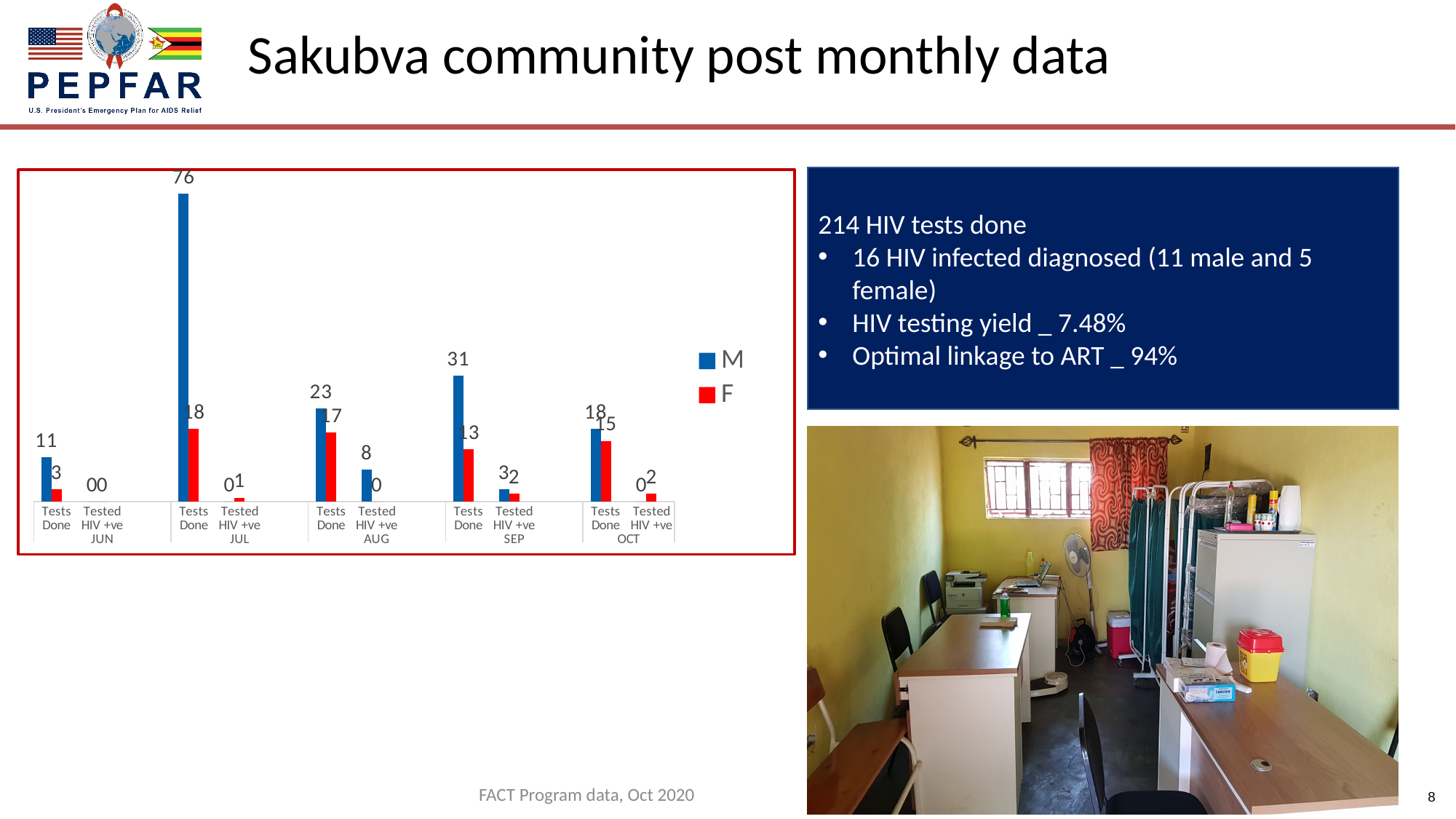
Which is larger for Tests Done in OCT, the M value or the F value? M Which colour represents the F series in the chart? red What is the total of the M and F values for Tests Done in JUN? 14 What is the value for F for Tested HIV +ve in OCT? 2 What type of chart is shown on the slide? bar chart What is the value for F for Tests Done in AUG? 17 In which month is the M value for Tests Done the highest? JUL In which month is the F value for Tests Done the lowest? JUN What is the value for M for Tested HIV +ve in AUG? 8 What is the value for M for Tests Done in JUL? 76 How many series does the chart legend list? 2 What is the difference between the M and F values for Tests Done in SEP? 18